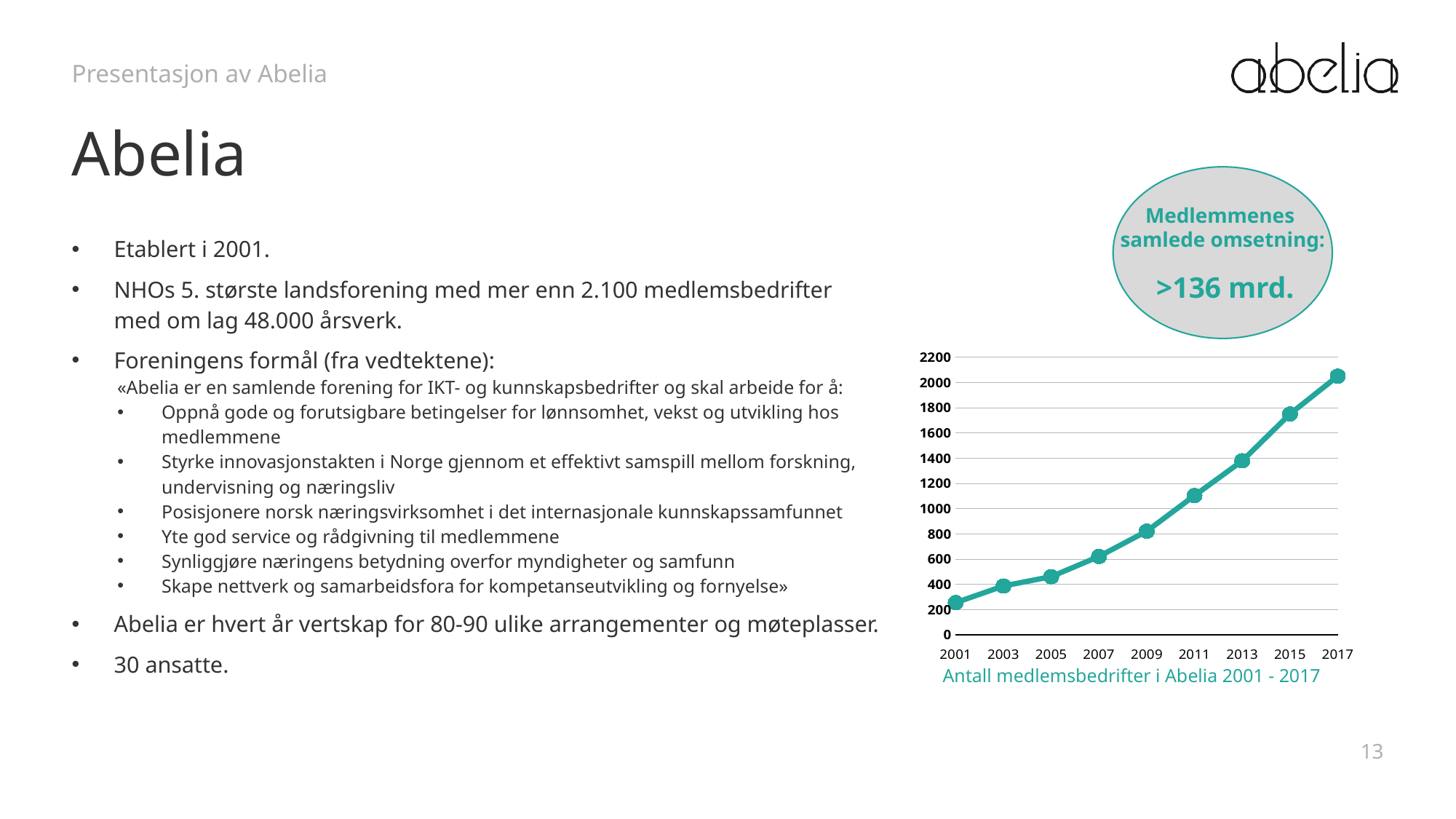
Which year has the highest number of member companies? 2017 Is the value for 2011 greater or less than 1000? greater What is the title of the chart? Antall medlemsbedrifter i Abelia 2001 - 2017 What is the highest value shown on the vertical axis? 2200 What kind of chart is shown on the slide? line chart Is the value for 2009 greater or less than 1000? less Is the value for 2017 greater or less than 2000? greater Do the values rise or fall from 2001 to 2017? rise Which year has the lowest number of member companies? 2001 Which is larger, the value for 2013 or the value for 2009? 2013 How many data points are plotted on the line? 9